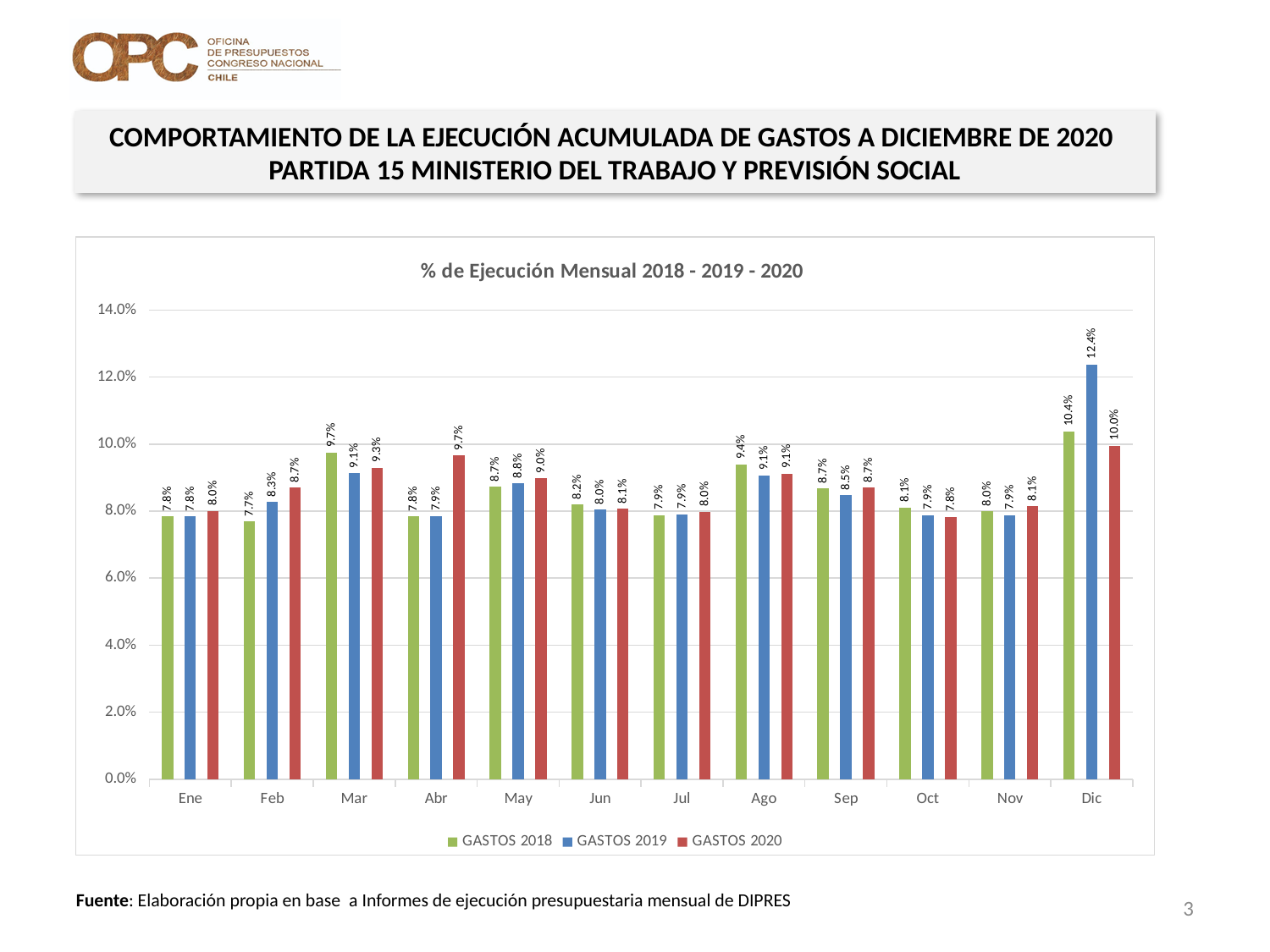
What is the value for GASTOS 2018 in Mar? 9.7% What is the value for GASTOS 2020 in Feb? 8.7% Which month has the lowest value for GASTOS 2020? Oct What is the difference between GASTOS 2019 and GASTOS 2020 in Dic? 2.4% What is the value for GASTOS 2020 in Abr? 9.7% What kind of chart is shown on the slide? Bar chart What is the value for GASTOS 2019 in Dic? 12.4% In Mar, which is larger: GASTOS 2018 or GASTOS 2019? GASTOS 2018 How many months are shown on the x axis? 12 How many series does the legend list? 3 Is the value for GASTOS 2019 in Dic greater or less than 12.0%? greater Which month has the highest value for GASTOS 2018? Dic